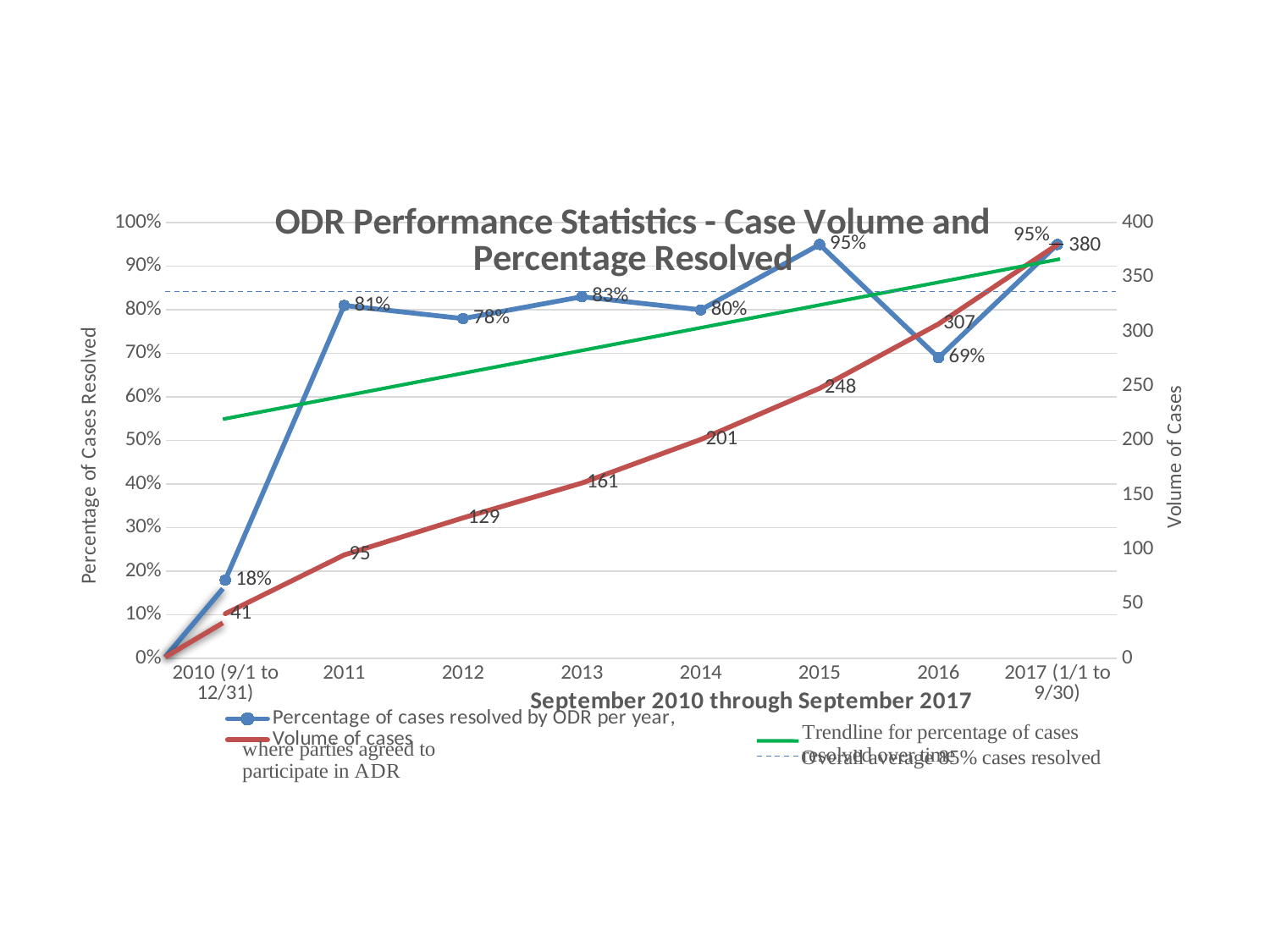
What is the volume of cases in 2014? 201 What percentage of cases was resolved by ODR in 2016? 69% How many entries does the legend list? 4 What kind of chart is this? Line chart What overall average percentage of cases resolved does the dashed line represent? 85% Which year has the highest volume of cases? 2017 (1/1 to 9/30) Does the volume of cases rise or fall from 2010 to 2017? Rise How many years (categories) are shown on the x axis? 8 Which year has the larger percentage of cases resolved, 2012 or 2013? 2013 What is the volume of cases in 2017 (1/1 to 9/30)? 380 What is the difference in volume of cases between 2016 and 2015? 59 Which year has the lowest percentage of cases resolved by ODR? 2010 (9/1 to 12/31)